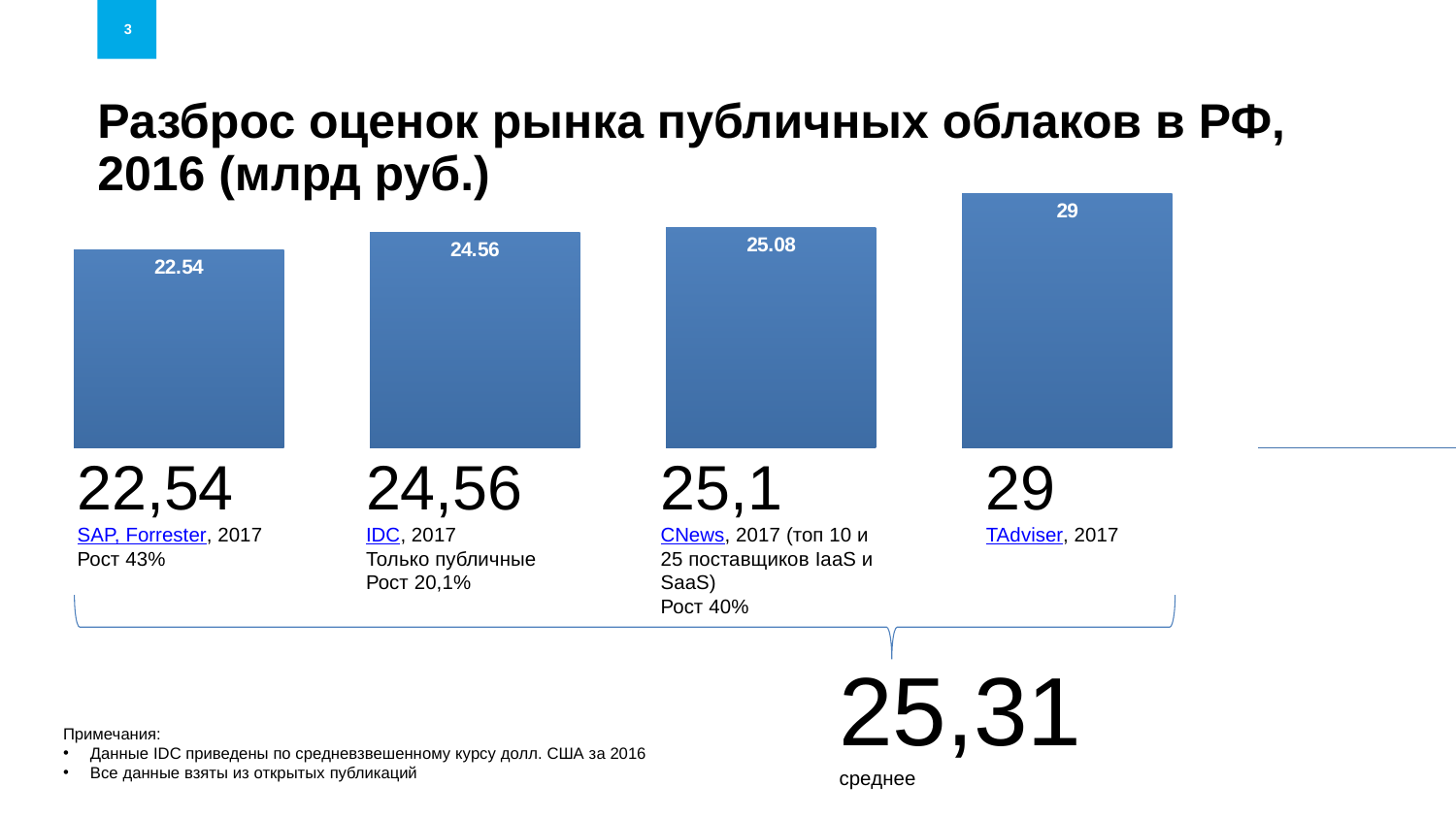
What is the data label on the bar for the TAdviser estimate? 29 Which source gives the lowest estimate of the market? SAP, Forrester What type of chart is shown on the slide? bar chart How many bars are plotted in the chart? 4 Which is larger, the IDC estimate or the CNews estimate? CNews What is the data label on the bar for the SAP, Forrester estimate? 22.54 What is the data label on the bar for the CNews estimate? 25.08 Do the bar values rise or fall from left to right? rise Which source gives the highest estimate of the market? TAdviser What average value (среднее) is shown below the chart? 25,31 What is the difference between the TAdviser bar (29) and the SAP, Forrester bar (22.54)? 6.46 What is the data label on the bar for the IDC estimate? 24.56